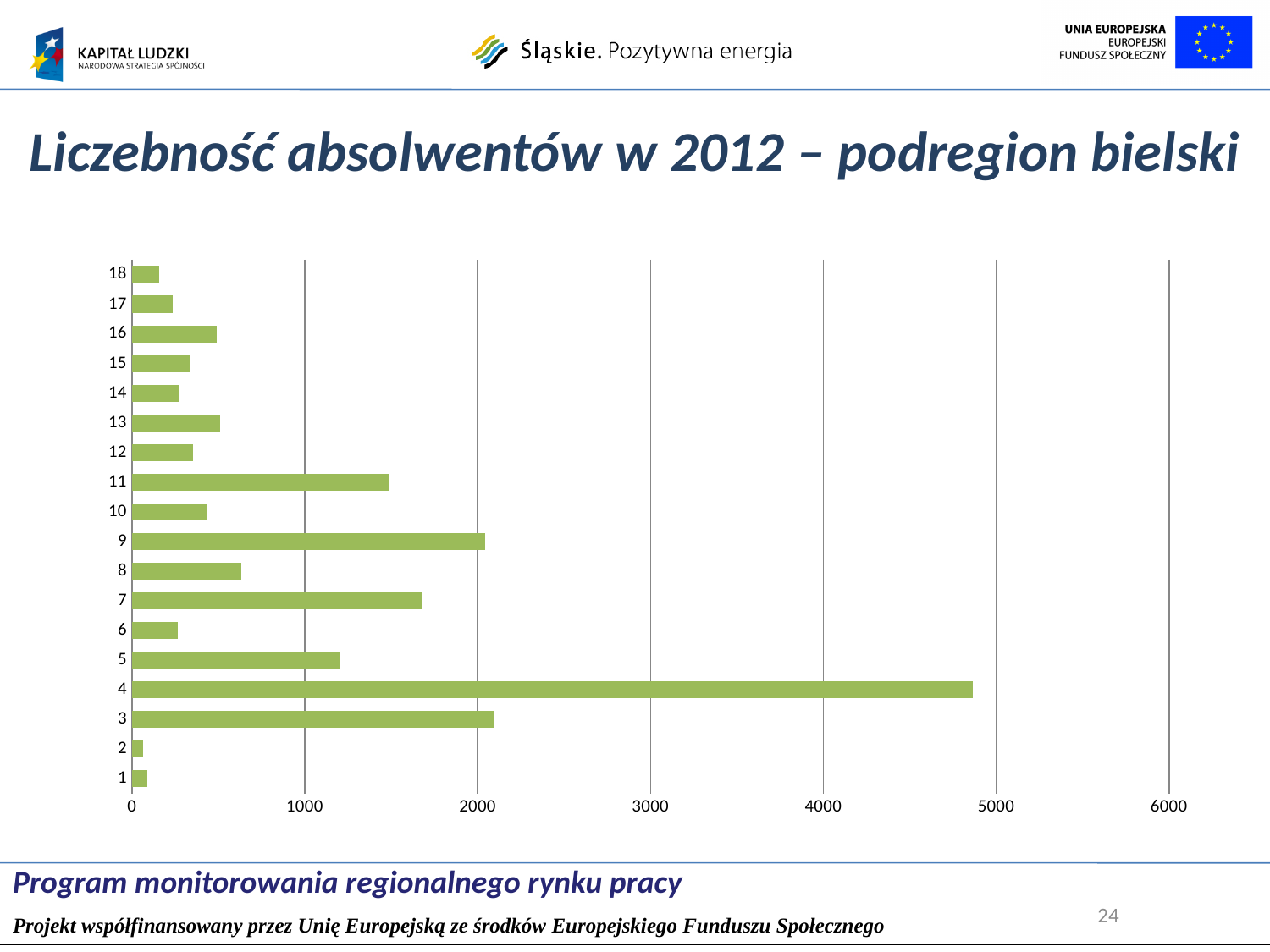
What kind of chart is shown on the slide? bar chart Which is larger, the value for category 7 or category 11? 7 Is the value for category 4 greater or less than 4000? greater Which is larger, the value for category 5 or category 8? 5 Which category has the highest value? 4 Is the value for category 7 greater or less than 1000? greater How many categories are plotted on the chart? 18 What is the title of the slide containing the chart? Liczebność absolwentów w 2012 – podregion bielski Is the value for category 3 greater or less than 2000? greater Which is larger, the value for category 4 or category 3? 4